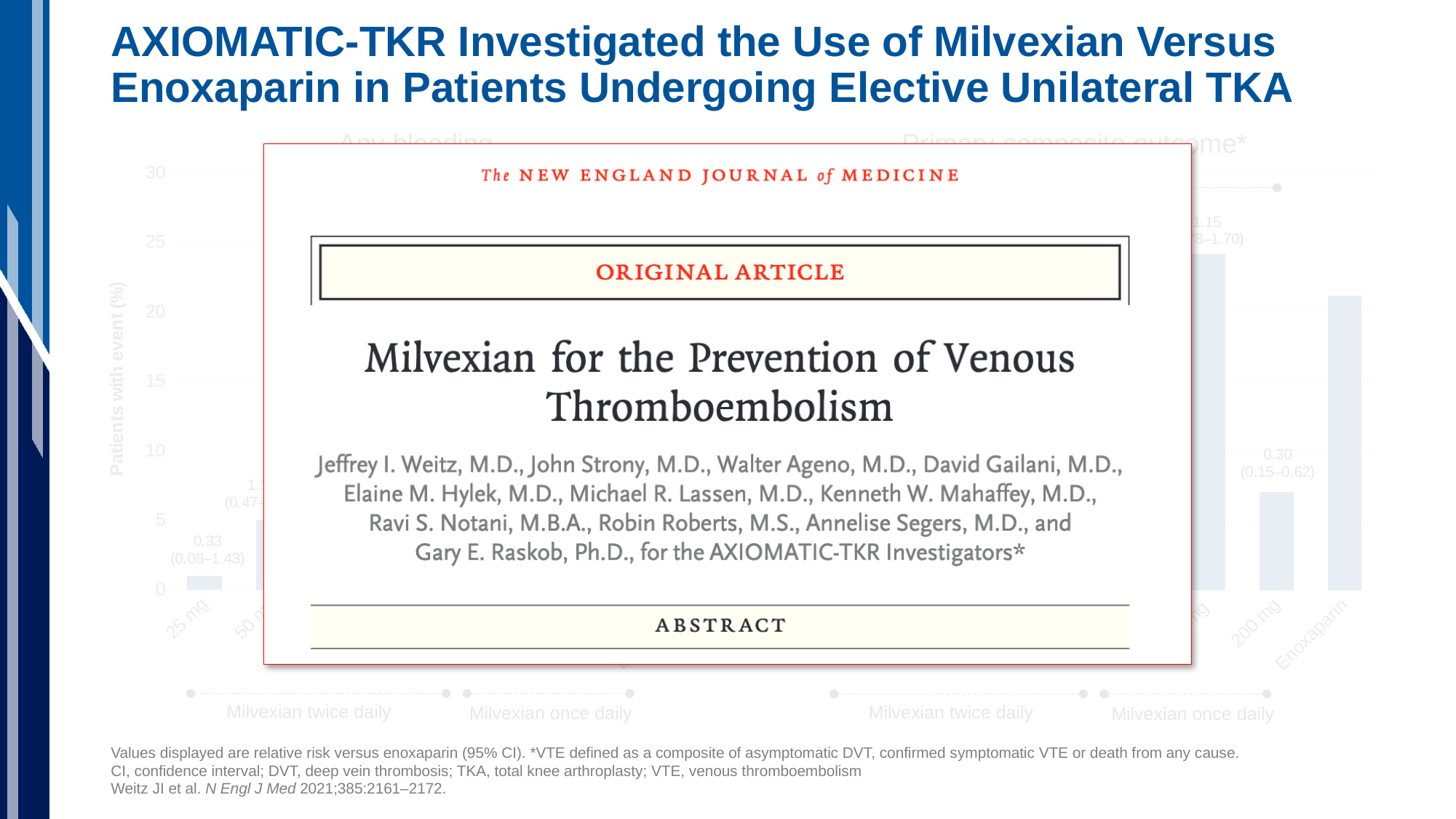
In the right chart, is the value for the Enoxaparin bar greater or less than 10? greater What is the highest tick value shown on the y-axis of the charts? 30 What is the y-axis label of the charts on the slide? Patients with event (%) What kind of chart is shown on the left side of the slide, behind the article image? bar chart In the left chart, is the value for the 25 mg bar greater or less than 5? less In the right chart (Primary composite outcome), what relative risk value (with 95% CI) is printed above the 200 mg bar? 0.30 (0.15–0.62) In the left chart, what relative risk value (with 95% CI) is printed above the 25 mg bar? 0.33 (0.08–1.43)